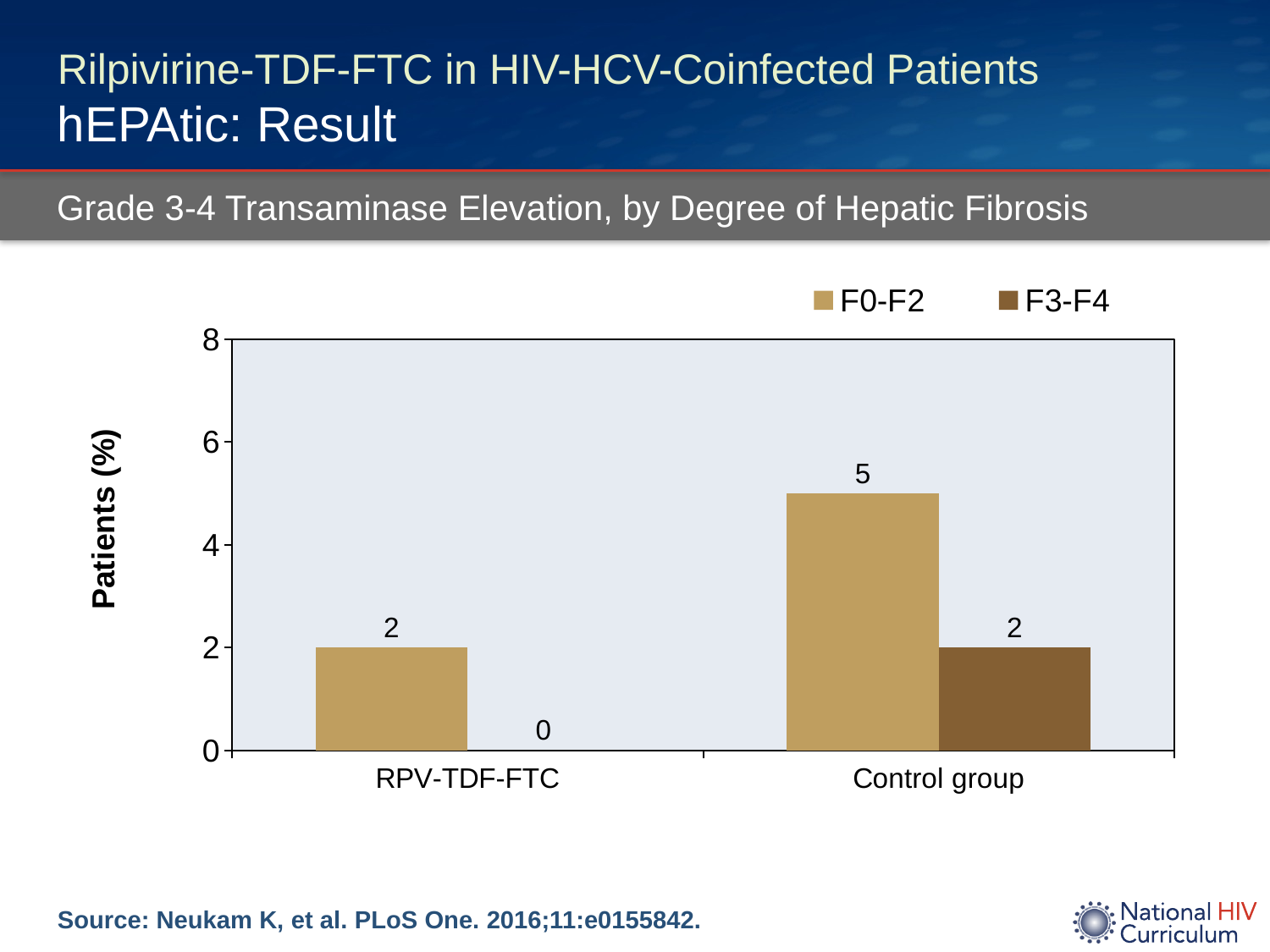
What is the difference between the F0-F2 values for the Control group and RPV-TDF-FTC? 3 What is the value for F3-F4 in the RPV-TDF-FTC group? 0 Is the F0-F2 value for the Control group greater or less than 4? greater What kind of chart is shown on the slide? Bar chart Which is larger in the Control group, the F0-F2 value or the F3-F4 value? F0-F2 What is the value for F0-F2 in the Control group? 5 How many groups are shown on the x axis? 2 Which group has the highest value for F0-F2? Control group What is the value for F0-F2 in the RPV-TDF-FTC group? 2 Which group has the lowest value for F3-F4? RPV-TDF-FTC How many series does the legend list? 2 What is the value for F3-F4 in the Control group? 2